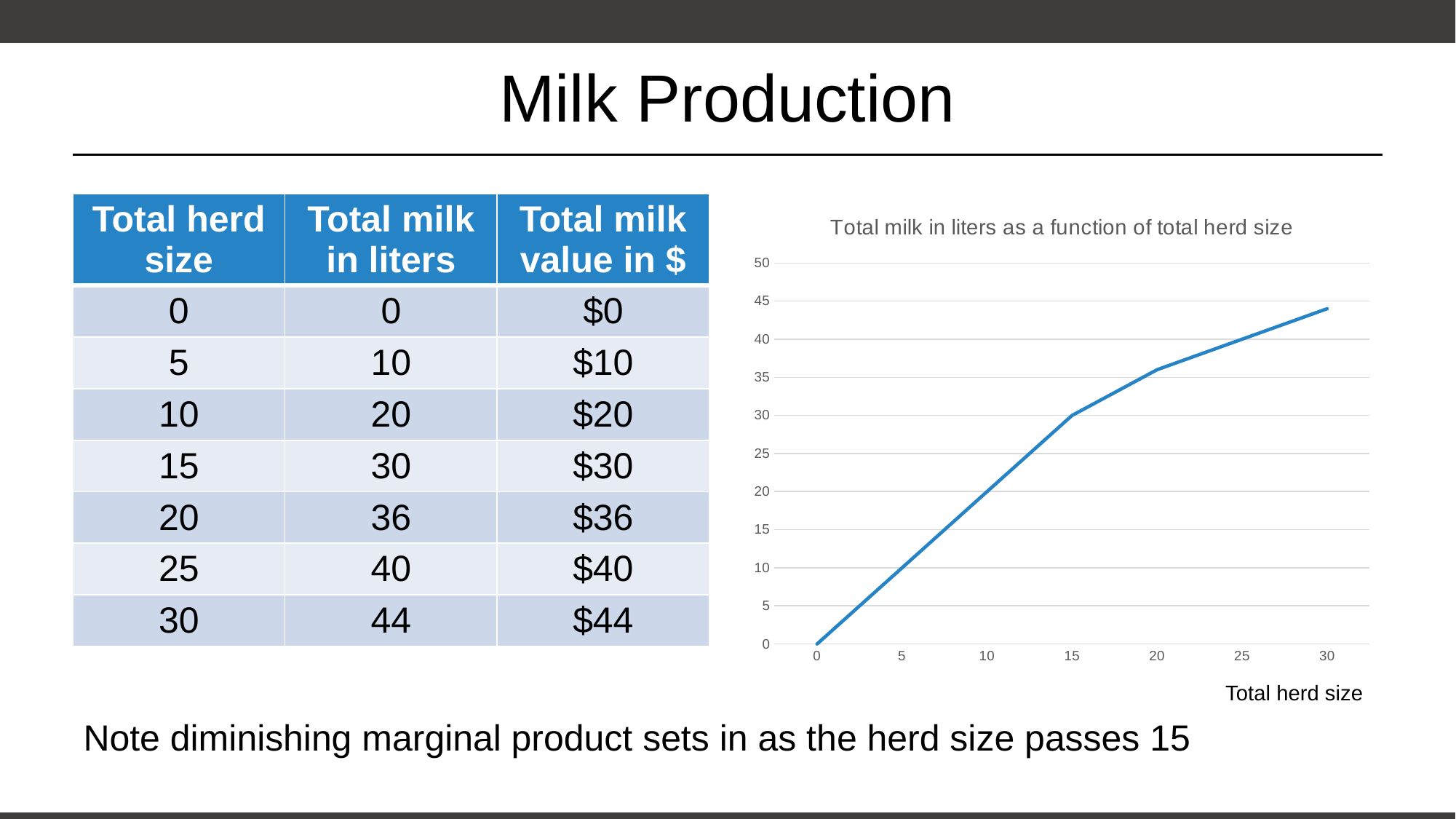
What is the title of the chart? Total milk in liters as a function of total herd size Does the total milk in liters rise or fall as the total herd size increases? rise Is the total milk in liters at a herd size of 30 greater or less than 40? greater How many data points are plotted on the line? 7 According to the chart, what is the total milk in liters when the total herd size is 0? 0 According to the chart, what is the total milk in liters when the total herd size is 10? 20 At which total herd size is the total milk in liters highest? 30 According to the chart, what is the total milk in liters when the total herd size is 15? 30 What is the label of the x axis of the chart? Total herd size Is the total milk in liters at a herd size of 20 greater or less than 40? less At which total herd size is the total milk in liters lowest? 0 What kind of chart is shown on the slide? line chart